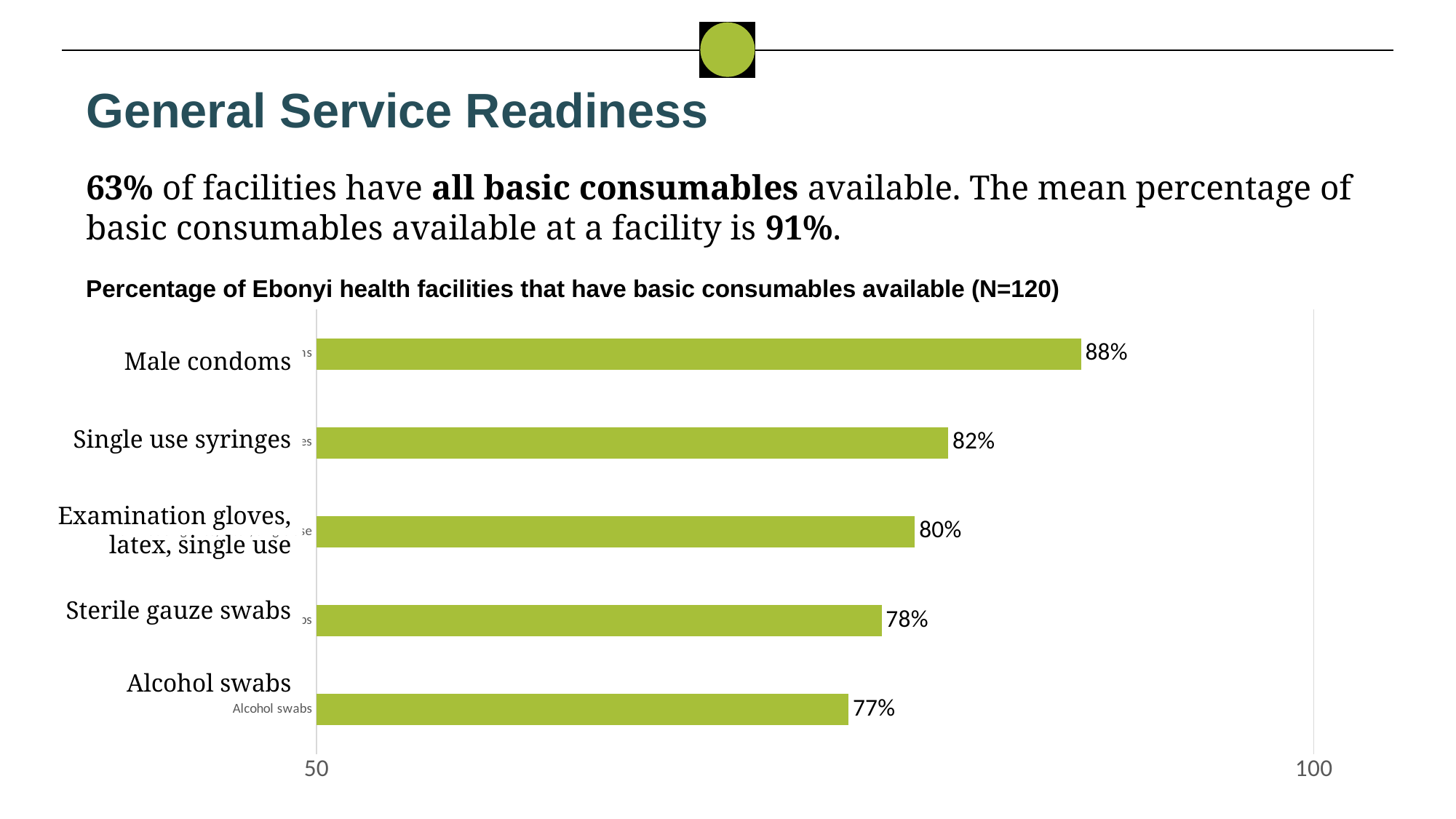
What percentage of facilities have alcohol swabs available? 77% Which has a higher value, sterile gauze swabs or examination gloves, latex, single use? Examination gloves, latex, single use What is the difference in percentage points between single use syringes and sterile gauze swabs? 4 What is the title of the chart? Percentage of Ebonyi health facilities that have basic consumables available (N=120) What is the difference in percentage points between male condoms and alcohol swabs? 11 What is the value shown for examination gloves, latex, single use? 80% Which consumable has the lowest percentage of facilities with it available? Alcohol swabs What percentage of facilities have single use syringes available? 82% What type of chart is shown on the slide? Bar chart What percentage of facilities have male condoms available? 88% How many consumables are shown in the chart? 5 Which consumable has the highest percentage of facilities with it available? Male condoms